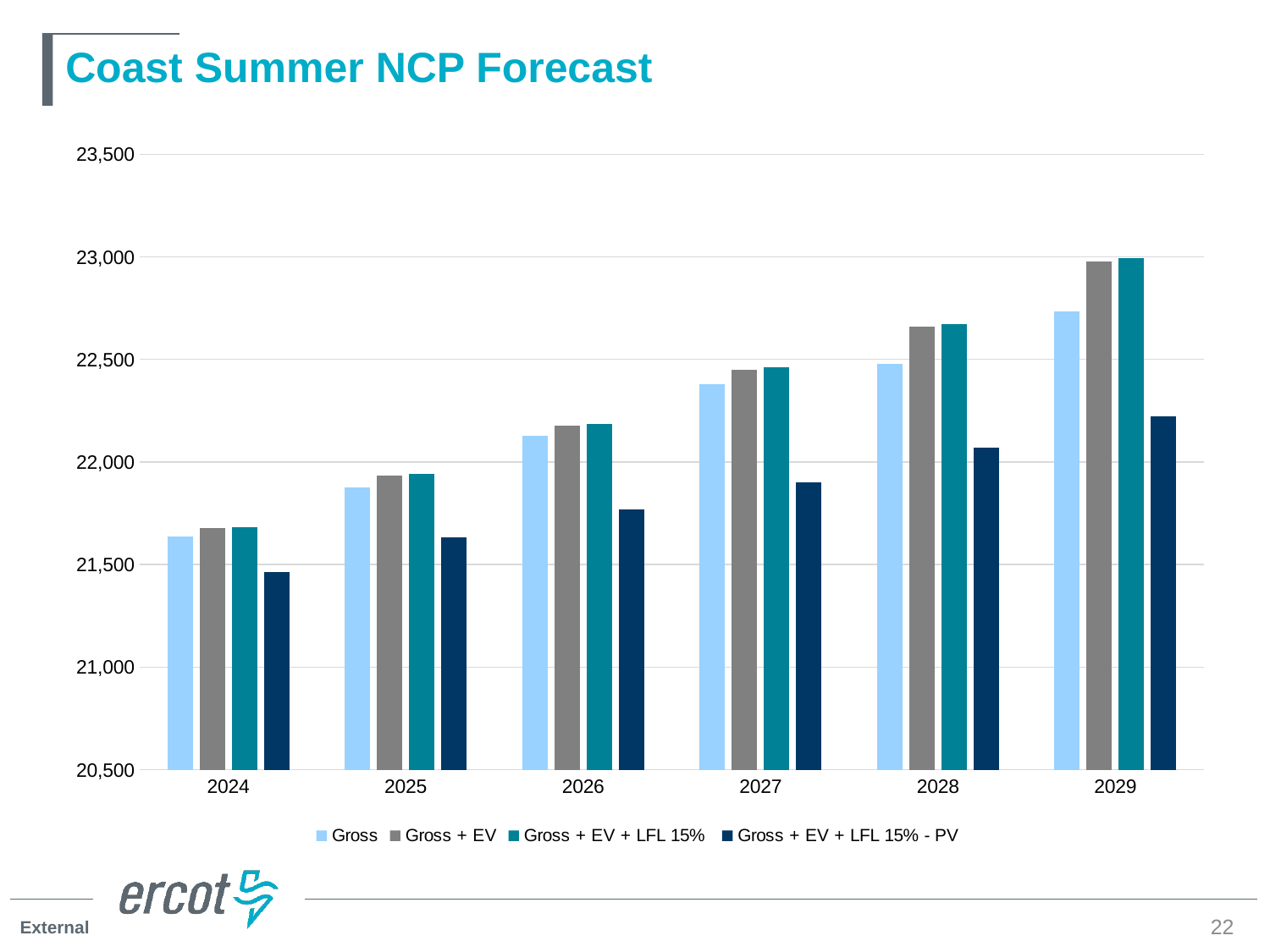
Is the value for Gross in 2026 greater or less than 22,000? greater In which year is the Gross value highest? 2029 How many years are shown on the x axis? 6 How many series does the legend list? 4 Is the value for Gross + EV + LFL 15% - PV in 2027 greater or less than 22,000? less Is the value for Gross + EV + LFL 15% - PV in 2029 greater or less than 22,000? greater What kind of chart is shown on the slide? bar chart In which year is the Gross + EV + LFL 15% - PV value lowest? 2024 Do the Gross values rise or fall from 2024 to 2029? rise